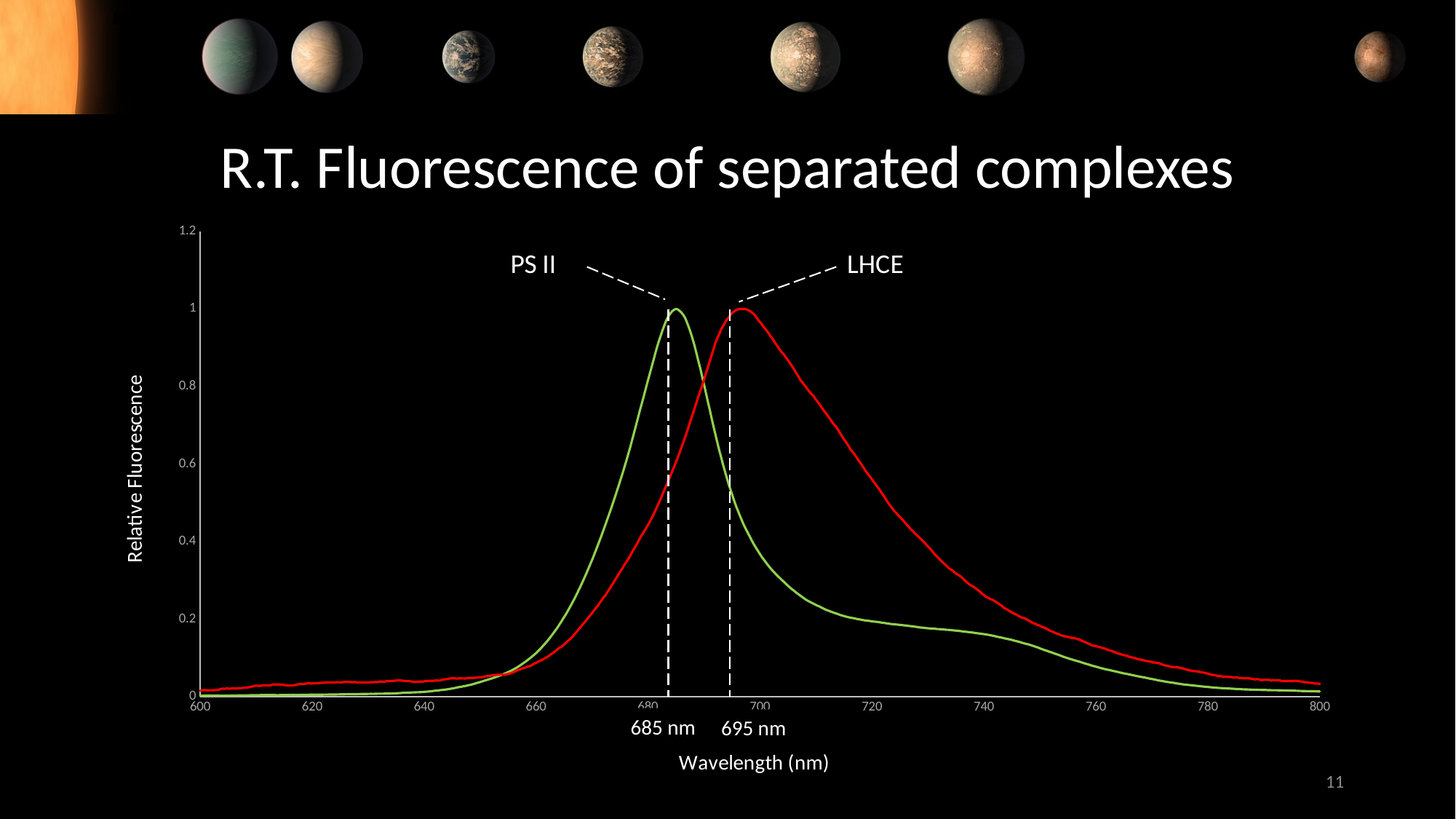
What kind of chart is shown on the slide? line chart At what wavelength does the PS II curve reach its peak? 685 nm Does the PS II curve rise or fall between 700 nm and 720 nm? fall What is the difference in nanometres between the peak wavelengths of LHCE and PS II? 10 nm Which complex has its fluorescence peak at the longer wavelength, PS II or LHCE? LHCE Is the relative fluorescence of PS II at 720 nm greater or less than 0.4? less Is the relative fluorescence of LHCE at 720 nm greater or less than 0.4? greater How many fluorescence curves are plotted on the chart? 2 What colour is the LHCE curve? red What is the title of the chart? R.T. Fluorescence of separated complexes At what wavelength does the LHCE curve reach its peak? 695 nm Is the relative fluorescence of LHCE at 760 nm greater or less than 0.2? less